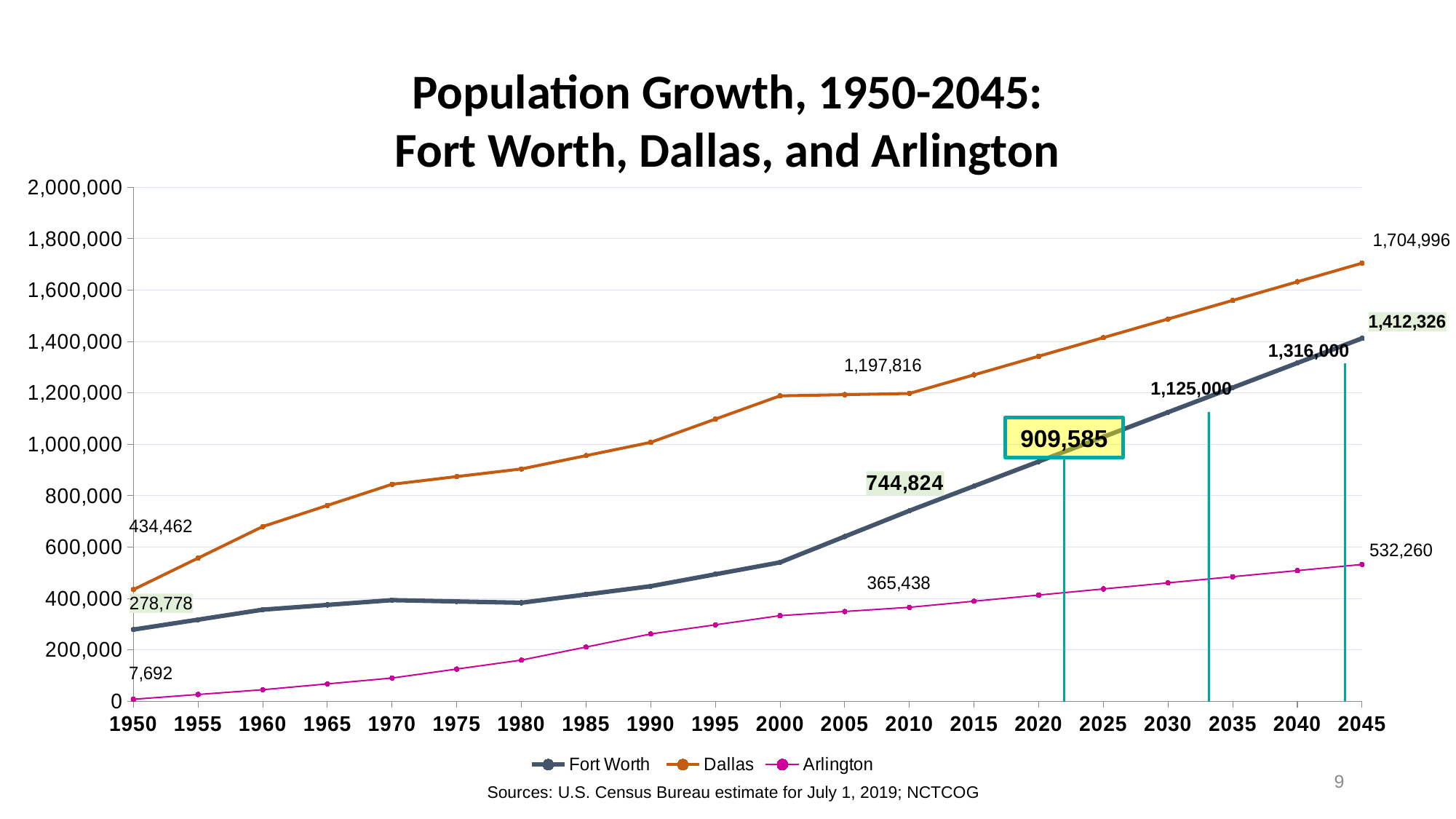
Does the Arlington line rise or fall from 1950 to 2045? rise Is the value for Fort Worth in 2000 greater or less than 600,000? less What is the population value shown for Arlington in 2010? 365,438 What kind of chart is shown on the slide? line chart Which city has the highest population in 2045? Dallas What is the population value shown for Dallas in 2045? 1,704,996 How many year points are shown along the x axis? 20 What is the difference between the Dallas and Fort Worth values in 2045? 292,670 By how much does the Fort Worth value increase from 2010 to 2045? 667,502 Which city has the lowest population in 1950? Arlington How many series does the legend list? 3 What is the population value shown for Fort Worth in 1950? 278,778